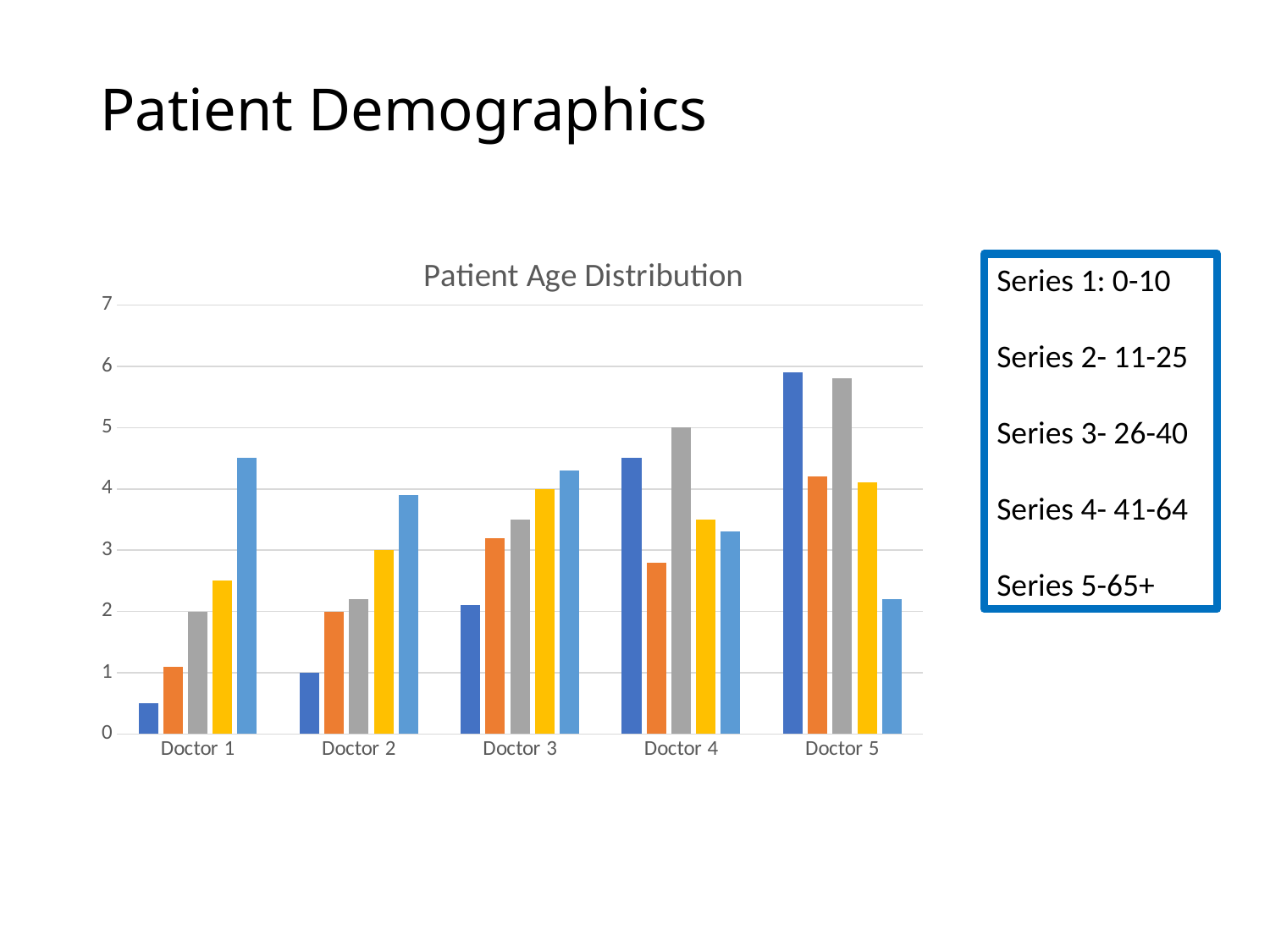
Which doctor has the shortest dark blue bar? Doctor 1 What is the difference between the gray bar for Doctor 4 and the gray bar for Doctor 1? 3 What is the title of the chart? Patient Age Distribution What is the value of the dark blue bar for Doctor 2? 1 How many series does the text box beside the chart list? 5 How many doctors (categories) are shown on the x axis of the chart? 5 Which doctor has the tallest dark blue bar? Doctor 5 What is the value of the gray bar for Doctor 4? 5 Which is larger: the light blue bar for Doctor 1 or the light blue bar for Doctor 5? Doctor 1 What is the value of the yellow bar for Doctor 3? 4 Is the value of the light blue bar for Doctor 1 greater or less than 4? greater What kind of chart is shown on the slide? bar chart